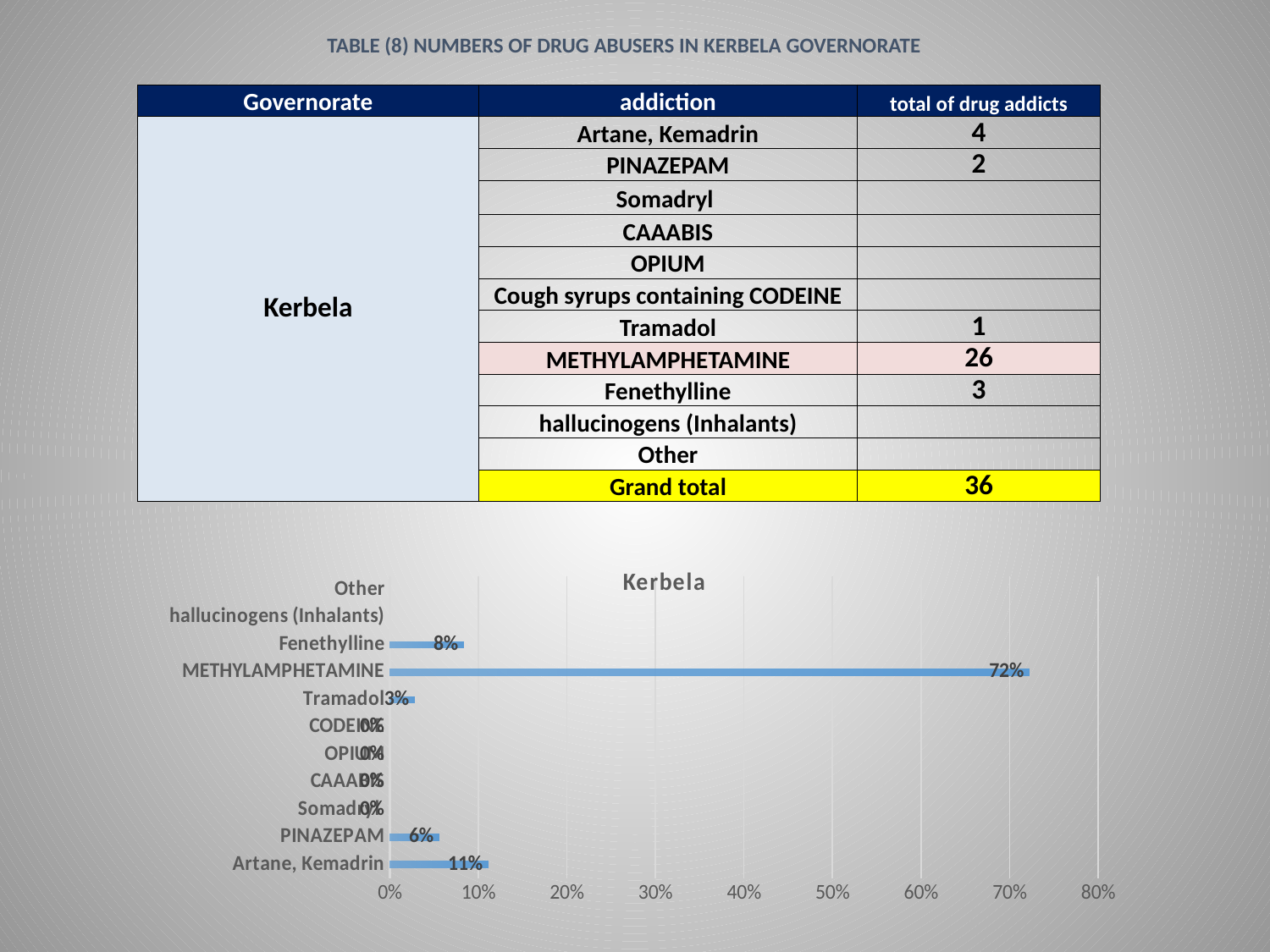
What is the value for METHYLAMPHETAMINE in the chart? 72% What is the value for Artane, Kemadrin in the chart? 11% What type of chart is shown on the slide? bar chart What is the chart's title? Kerbela Is the value for METHYLAMPHETAMINE greater or less than 70%? greater What is the value for Tramadol in the chart? 3% Which is larger, the value for Fenethylline or the value for PINAZEPAM? Fenethylline Which category has the highest value in the chart? METHYLAMPHETAMINE What is the value for Fenethylline in the chart? 8% What is the difference between the values for METHYLAMPHETAMINE and Artane, Kemadrin? 61% What is the value for PINAZEPAM in the chart? 6% How many categories are listed on the chart's vertical axis? 11